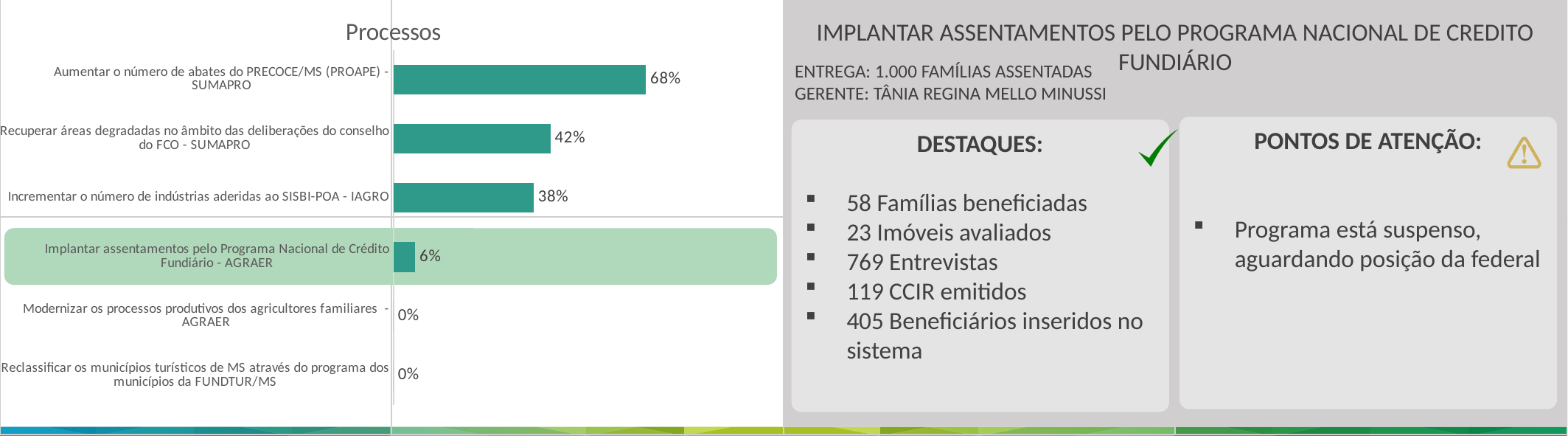
What is the value for "Incrementar o número de indústrias aderidas ao SISBI-POA - IAGRO"? 38% Which category has the highest value? Aumentar o número de abates do PRECOCE/MS (PROAPE) - SUMAPRO What is the value for "Modernizar os processos produtivos dos agricultores familiares - AGRAER"? 0% What is the title of the chart? Processos What is the value for "Aumentar o número de abates do PRECOCE/MS (PROAPE) - SUMAPRO"? 68% Which is larger: the value for "Recuperar áreas degradadas no âmbito das deliberações do conselho do FCO - SUMAPRO" or for "Incrementar o número de indústrias aderidas ao SISBI-POA - IAGRO"? Recuperar áreas degradadas no âmbito das deliberações do conselho do FCO - SUMAPRO What is the difference between the values for "Aumentar o número de abates do PRECOCE/MS (PROAPE) - SUMAPRO" and "Recuperar áreas degradadas no âmbito das deliberações do conselho do FCO - SUMAPRO"? 26% What type of chart is shown on the slide? bar chart How many categories in the chart have a value of 0%? 2 What is the value for "Recuperar áreas degradadas no âmbito das deliberações do conselho do FCO - SUMAPRO"? 42% How many categories does the chart show? 6 What is the value for "Implantar assentamentos pelo Programa Nacional de Crédito Fundiário - AGRAER"? 6%